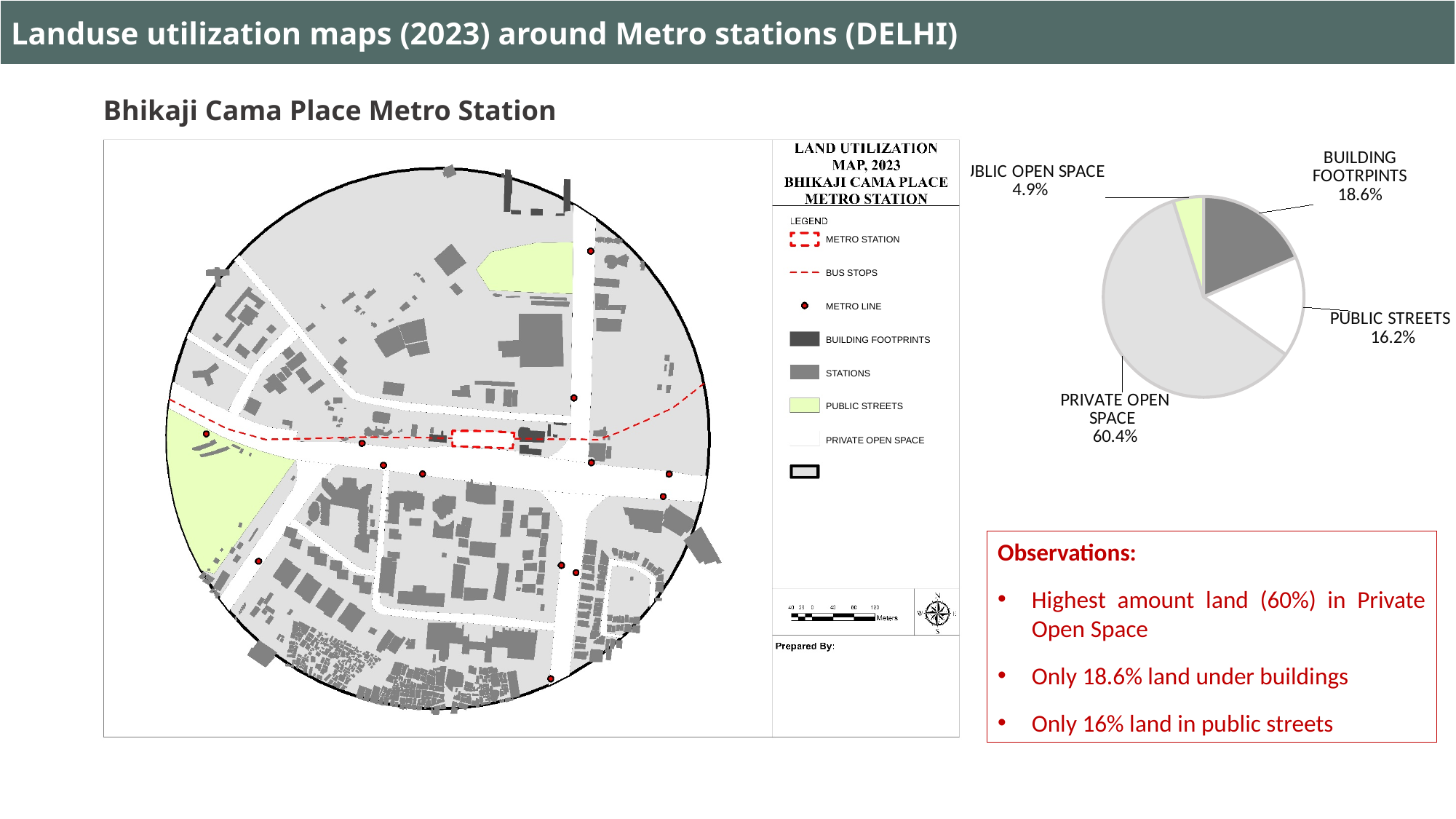
In the pie chart, which is larger: Building Footprints or Public Streets? Building Footprints What kind of chart is shown on the right side of the slide? Pie chart In the pie chart, what share of land is Public Streets? 16.2% In the pie chart, what share of land is Public Open Space? 4.9% In the pie chart, what share of land is Private Open Space? 60.4% What is the difference in percentage points between Private Open Space and Building Footprints in the pie chart? 41.8 Which metro station does the slide's land utilization map and pie chart refer to? Bhikaji Cama Place Metro Station How many slices does the pie chart have? 4 What is the difference in percentage points between Building Footprints and Public Streets in the pie chart? 2.4 Which category has the smallest slice in the pie chart? Public Open Space Which category has the largest slice in the pie chart? Private Open Space In the pie chart, what share of land is Building Footprints? 18.6%